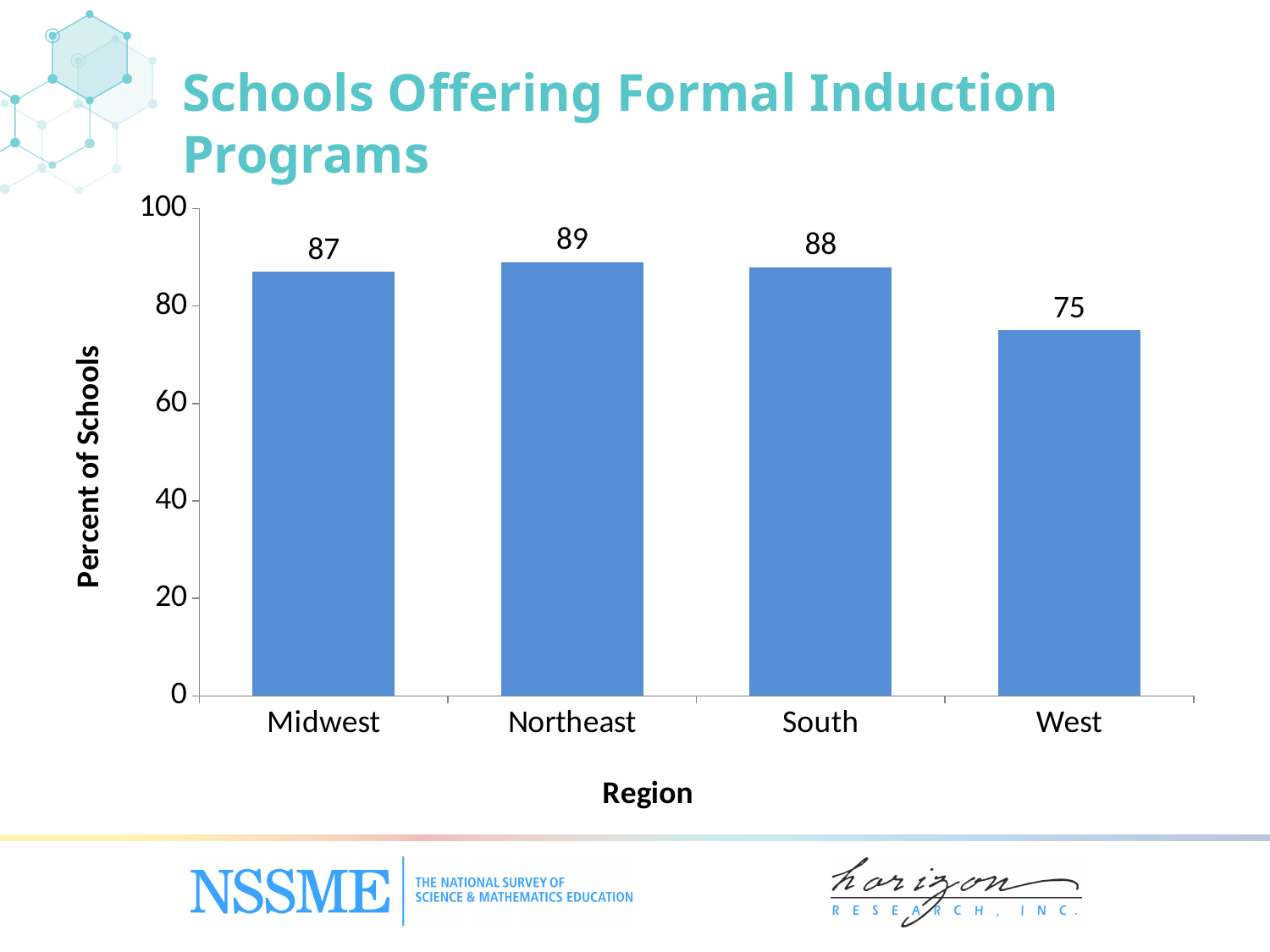
What is the value for Midwest? 87 What is the difference between the values for Northeast and West? 14 Is the value for West greater or less than 80? less Which region has the lowest percent of schools? West What is the title of the chart? Schools Offering Formal Induction Programs What is the difference between the values for Midwest and West? 12 How many regions are shown on the chart? 4 What is the value for West? 75 What kind of chart is shown on the slide? bar chart What is the value for Northeast? 89 What is the value for South? 88 Which is larger, the value for Midwest or the value for West? Midwest